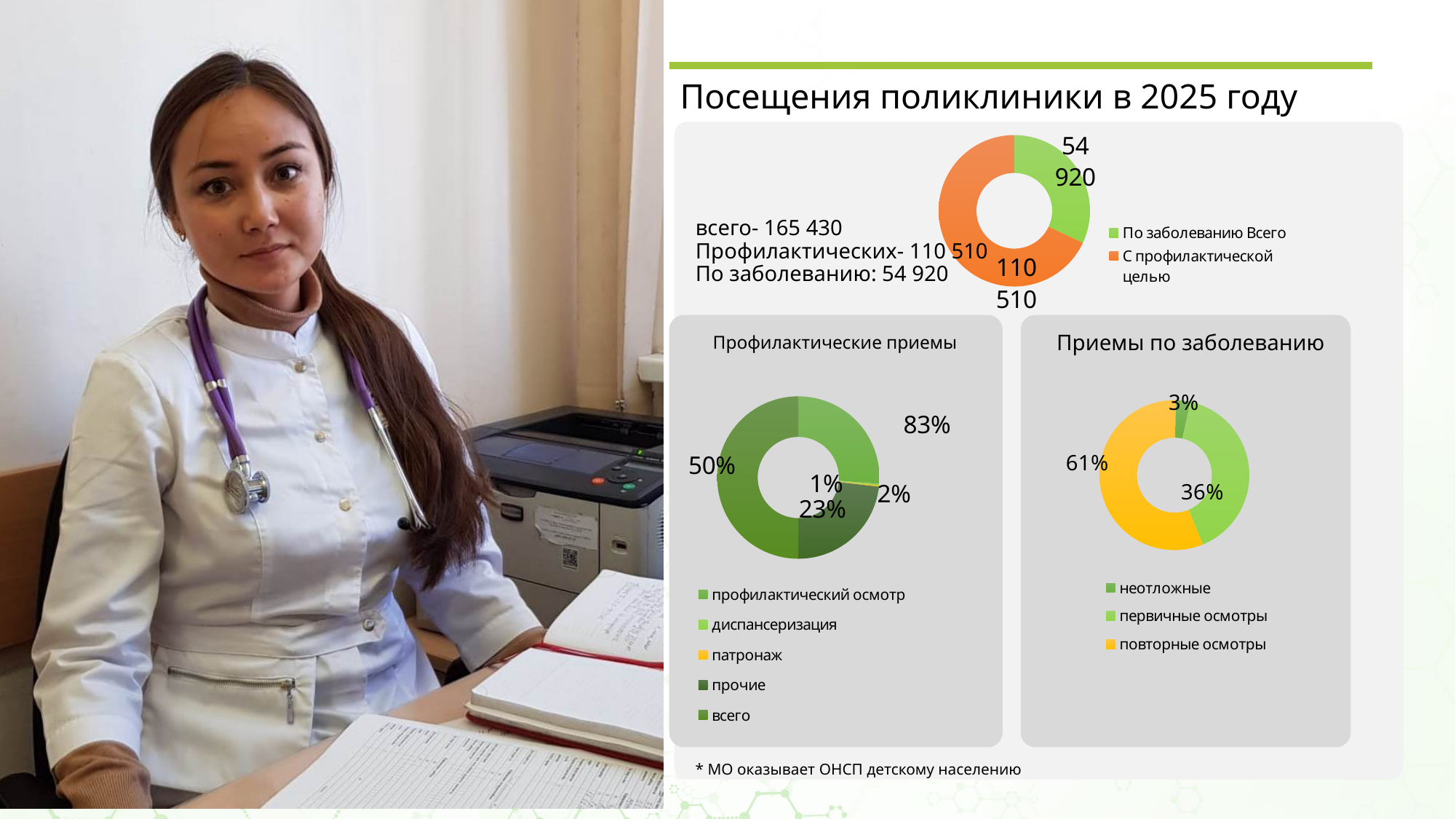
In the top chart 'Посещения поликлиники в 2025 году', which category has the larger value? С профилактической целью In the chart 'Приемы по заболеванию', what is the share for 'неотложные'? 3% In the top chart 'Посещения поликлиники в 2025 году', what is the value for 'С профилактической целью'? 110 510 In the chart 'Приемы по заболеванию', which is larger: 'первичные осмотры' or 'повторные осмотры'? повторные осмотры How many entries does the legend of the chart 'Профилактические приемы' list? 5 In the top chart 'Посещения поликлиники в 2025 году', what is the difference between 'С профилактической целью' and 'По заболеванию Всего'? 55 590 What kind of chart is the top chart under the title 'Посещения поликлиники в 2025 году'? doughnut chart In the chart 'Приемы по заболеванию', which category has the smallest share? неотложные In the top chart 'Посещения поликлиники в 2025 году', what is the value for 'По заболеванию Всего'? 54 920 In the chart 'Приемы по заболеванию', what is the share for 'повторные осмотры'? 61% How many entries does the legend of the top chart 'Посещения поликлиники в 2025 году' list? 2 How many categories does the chart 'Приемы по заболеванию' show? 3